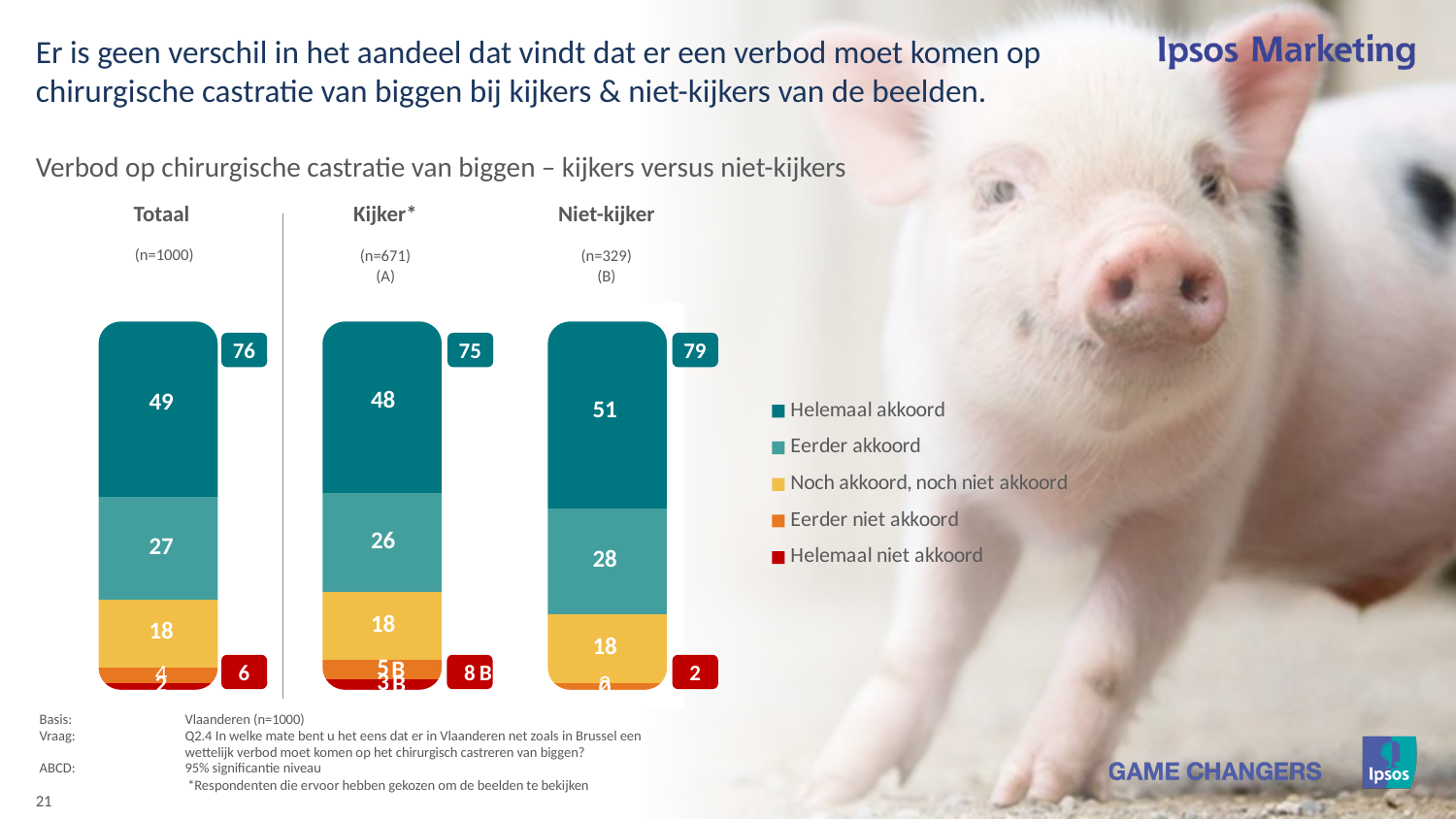
What is the combined value of 'Helemaal akkoord' and 'Eerder akkoord' for the Totaal bar, as shown in the box next to it? 76 Which group has the lowest value for 'Helemaal akkoord'? Kijker* What is the difference between the 'Helemaal akkoord' values for Niet-kijker and Kijker*? 3 What is the sample size (n) for the Niet-kijker group? n=329 Which group has the highest value for 'Helemaal akkoord'? Niet-kijker What is the value for 'Helemaal akkoord' in the Totaal bar? 49 What is the value for 'Noch akkoord, noch niet akkoord' in the Kijker* bar? 18 Which is larger, the 'Eerder akkoord' value for Totaal or for Kijker*? Totaal How many groups (bars) are shown in the chart? 3 What kind of chart is shown on the slide? Stacked bar chart What is the value for 'Eerder akkoord' in the Niet-kijker bar? 28 How many series does the legend list? 5